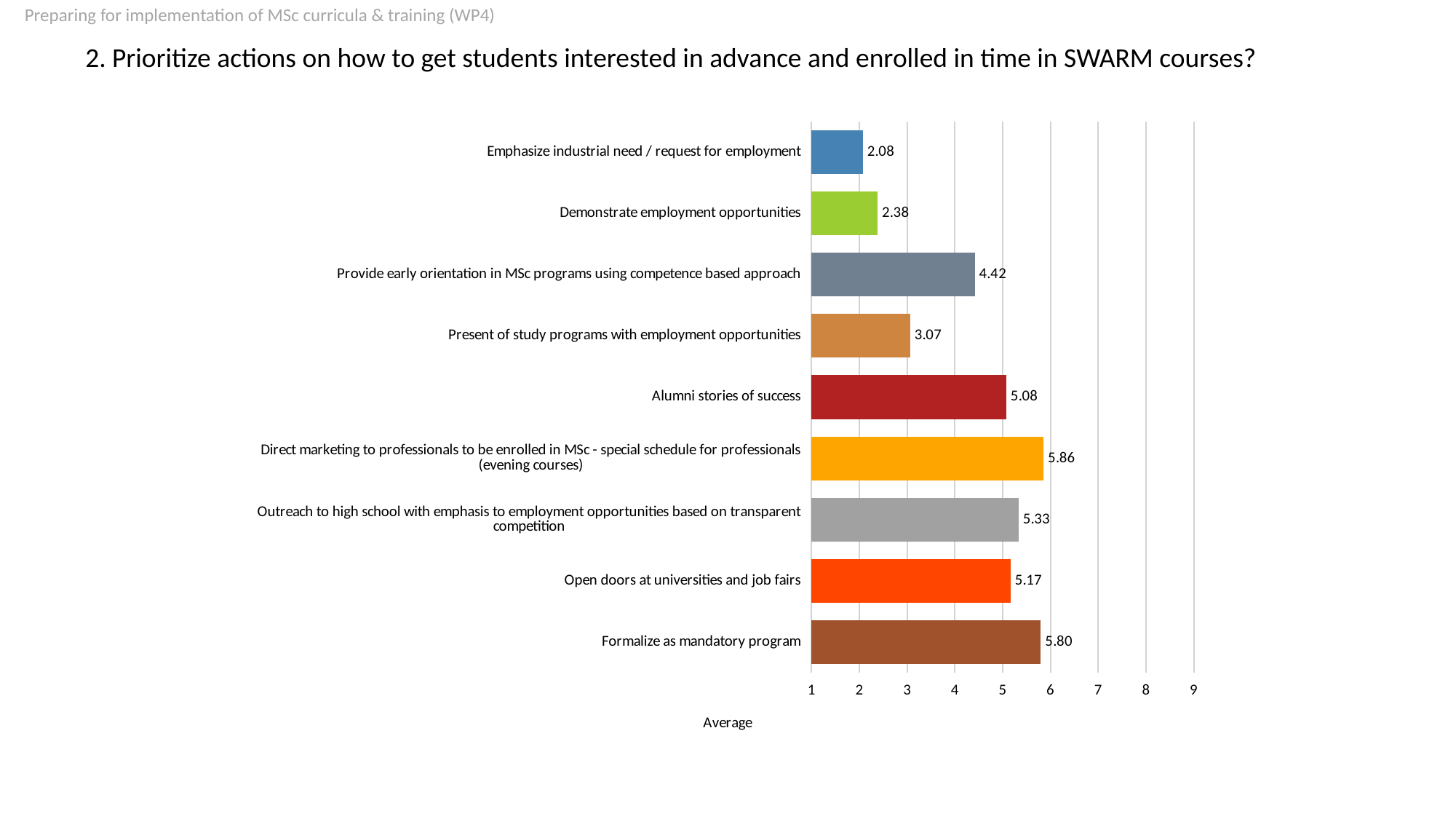
What is the average value for "Open doors at universities and job fairs"? 5.17 What is the average value for "Provide early orientation in MSc programs using competence based approach"? 4.42 What kind of chart is shown on the slide? Bar chart What is the difference between the values for "Formalize as mandatory program" and "Demonstrate employment opportunities"? 3.42 Which has a larger value: "Present of study programs with employment opportunities" or "Outreach to high school with emphasis to employment opportunities based on transparent competition"? Outreach to high school with emphasis to employment opportunities based on transparent competition What is the label of the horizontal axis? Average Which action has the highest average value? Direct marketing to professionals to be enrolled in MSc - special schedule for professionals (evening courses) Is the value for "Emphasize industrial need / request for employment" greater or less than 3? less What is the average value for "Alumni stories of success"? 5.08 What is the difference between the values for "Direct marketing to professionals to be enrolled in MSc - special schedule for professionals (evening courses)" and "Alumni stories of success"? 0.78 Which action has the lowest average value? Emphasize industrial need / request for employment How many actions (categories) are shown in the chart? 9